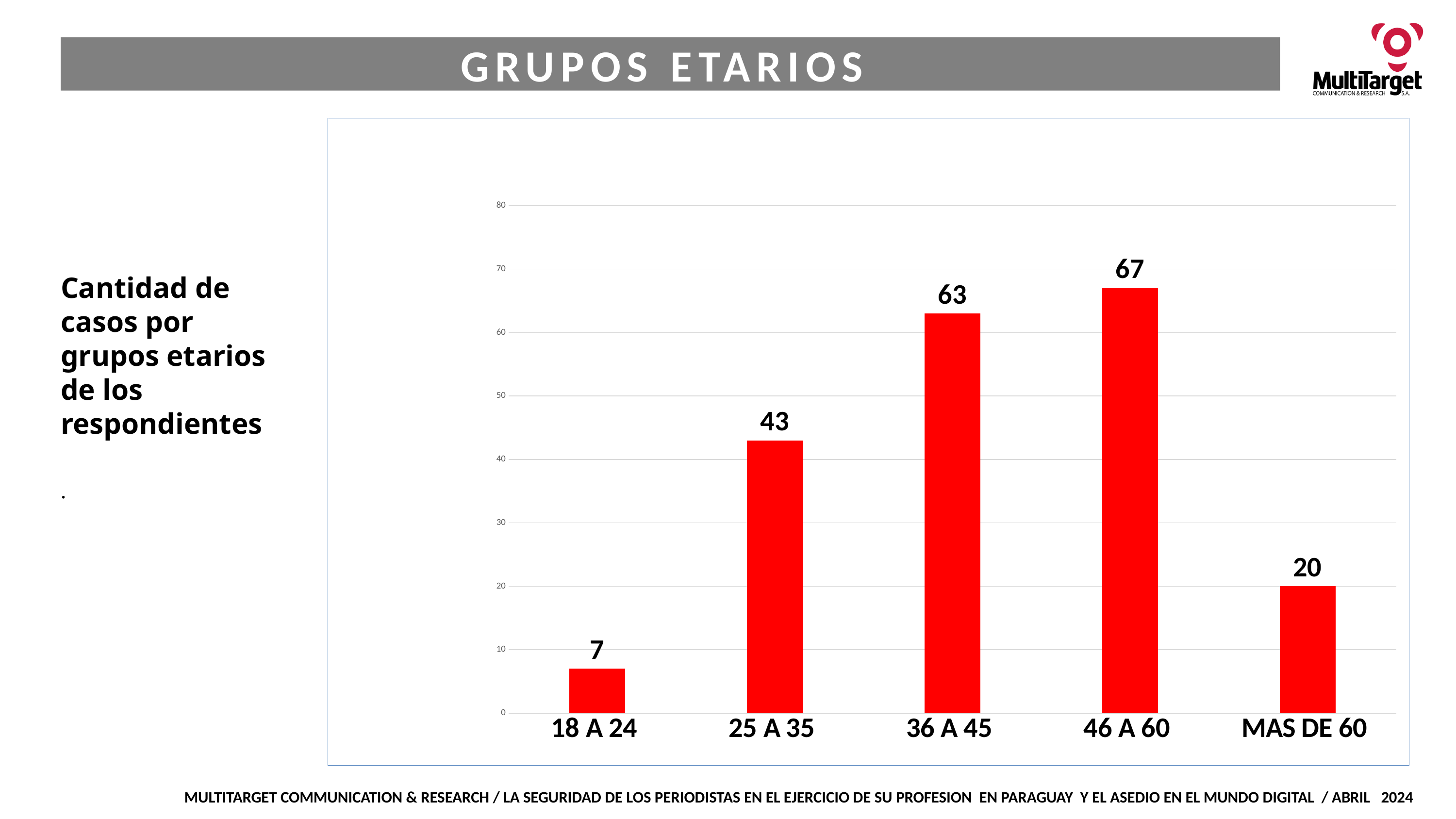
What is the value for the 18 A 24 age group? 7 Is the value for 36 A 45 greater or less than 60? greater What is the value for the 25 A 35 age group? 43 What kind of chart is shown on the slide? bar chart Which age group has the lowest value? 18 A 24 What is the title shown in the header bar of the slide? GRUPOS ETARIOS Which is larger, the value for 25 A 35 or the value for MAS DE 60? 25 A 35 What is the value for the MAS DE 60 age group? 20 What is the difference between the values for 25 A 35 and MAS DE 60? 23 Which age group has the highest value? 46 A 60 What is the difference between the values for 46 A 60 and 36 A 45? 4 How many age groups are shown in the chart? 5